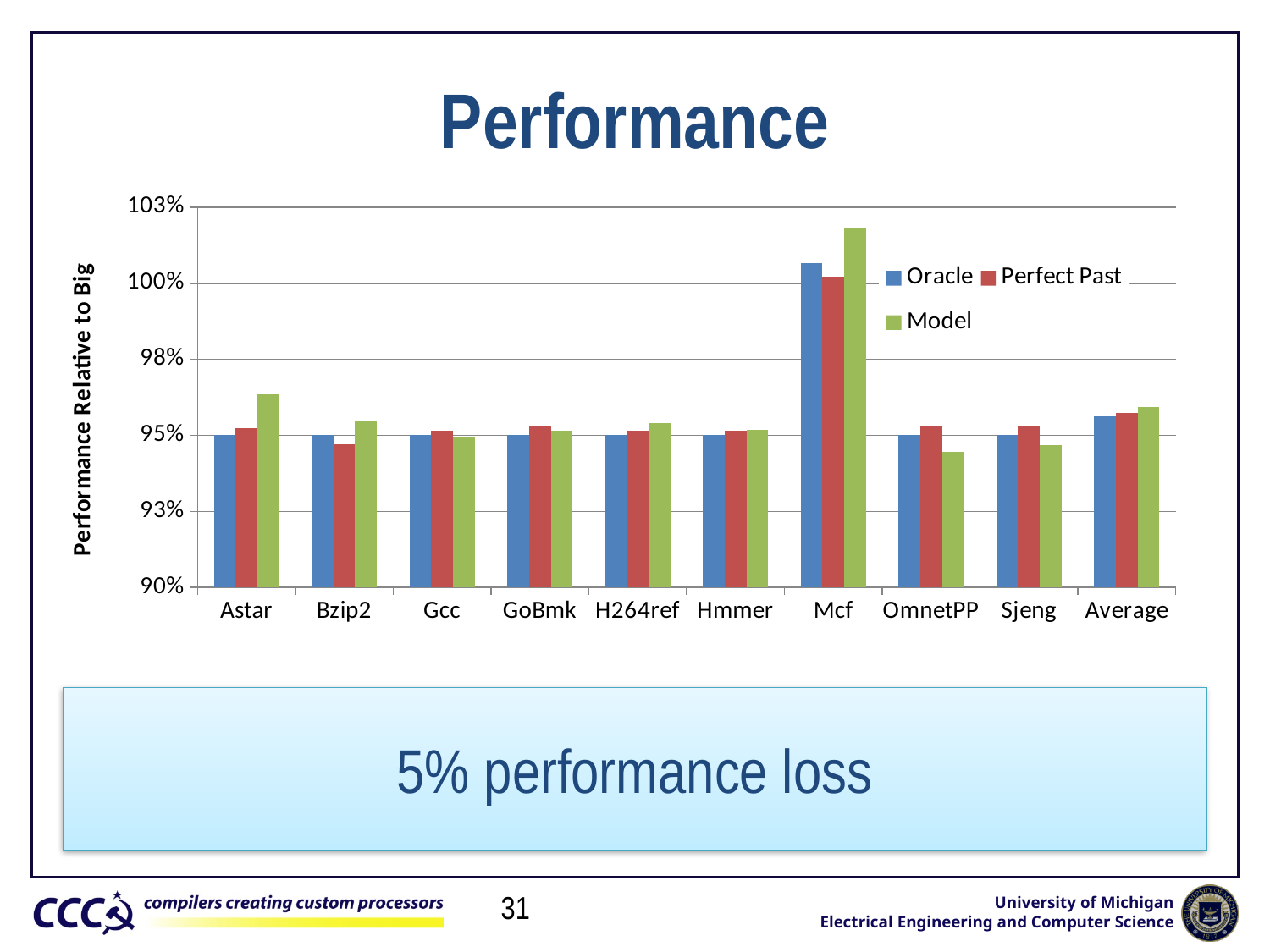
Which category has the highest Model value? Mcf What kind of chart is shown on the slide? bar chart How many series does the chart's legend list? 3 Is the Model value for OmnetPP greater or less than 95%? less Which category has the highest Oracle value? Mcf Is the Model value for Mcf greater or less than 100%? greater Is the Oracle value for Mcf greater or less than 100%? greater How many categories are shown along the x axis of the chart? 10 What is the title of the chart's y axis? Performance Relative to Big Which series is shown in green in the chart? Model For Mcf, which is larger: the Oracle value or the Model value? Model